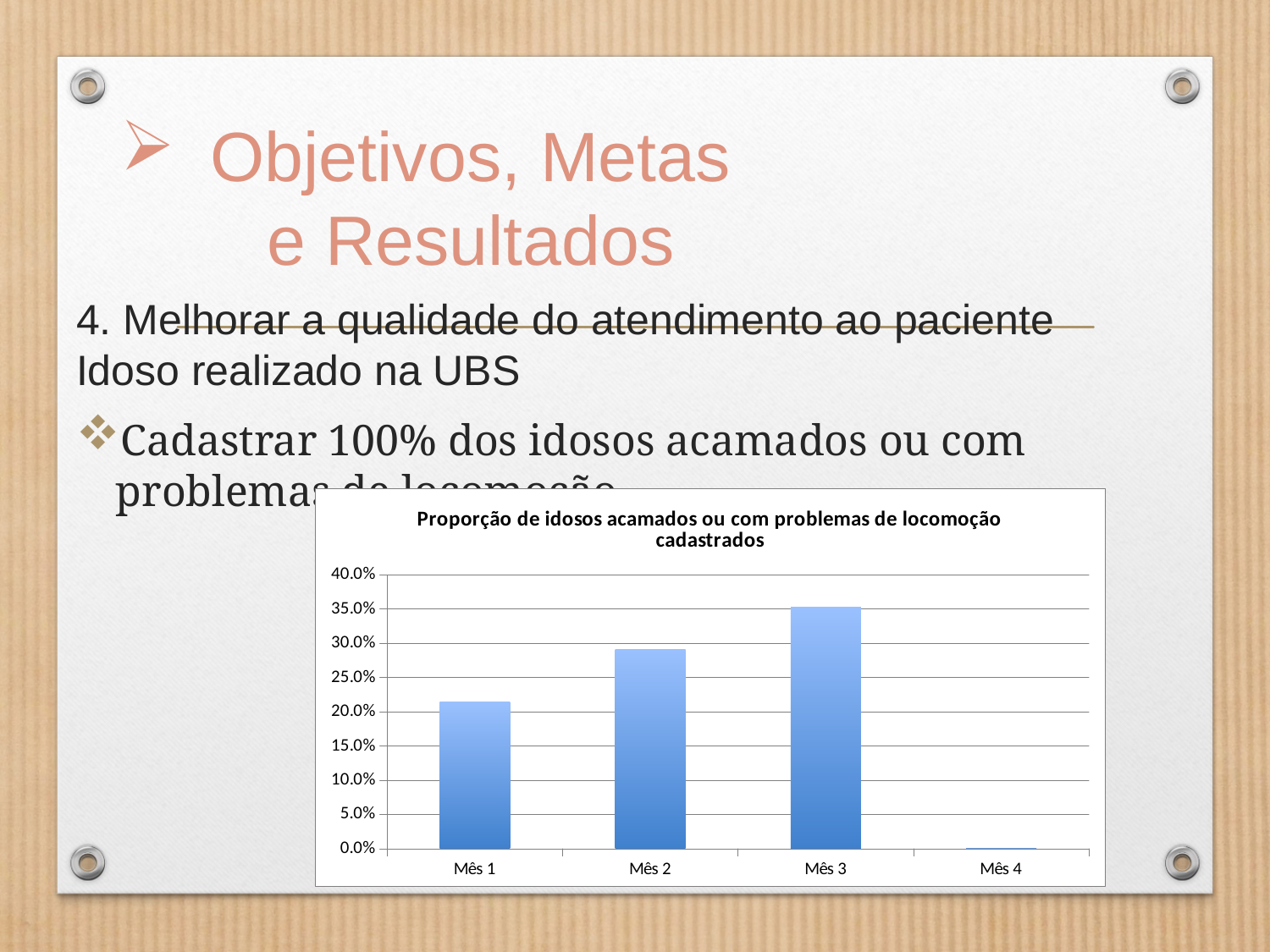
Is the value for Mês 4 greater or less than 5.0%? less What is the title of the chart? Proporção de idosos acamados ou com problemas de locomoção cadastrados What kind of chart is shown on the slide? bar chart Which month has the lowest proportion in the chart? Mês 4 Do the values rise or fall from Mês 1 to Mês 3? rise Which month has the highest proportion in the chart? Mês 3 Is the value for Mês 1 greater or less than 20.0%? greater How many categories are shown on the x axis of the chart? 4 What is the highest value shown on the chart's y axis? 40.0% Which is larger, the value for Mês 1 or the value for Mês 2? Mês 2 Is the value for Mês 2 greater or less than 30.0%? less